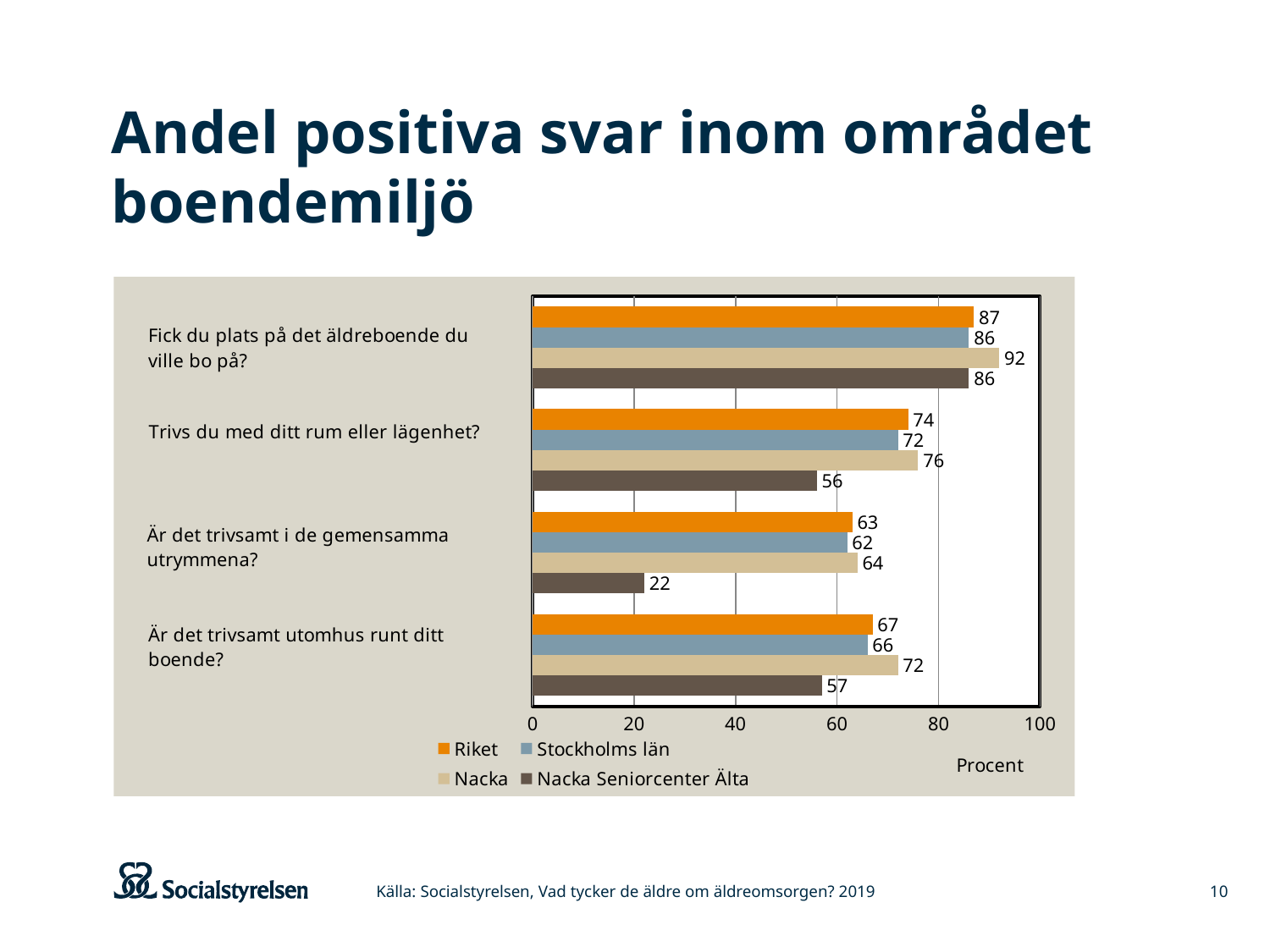
Is the value for Nacka Seniorcenter Älta on "Är det trivsamt i de gemensamma utrymmena?" greater or less than 40? less Which question has the lowest value for Nacka Seniorcenter Älta? Är det trivsamt i de gemensamma utrymmena? Which series has the highest value on "Fick du plats på det äldreboende du ville bo på?"? Nacka Which is larger on "Är det trivsamt utomhus runt ditt boende?": Nacka or Nacka Seniorcenter Älta? Nacka What is the value for Nacka Seniorcenter Älta on "Är det trivsamt i de gemensamma utrymmena?"? 22 What is the value for Nacka on "Fick du plats på det äldreboende du ville bo på?"? 92 What is the value for Stockholms län on "Är det trivsamt utomhus runt ditt boende?"? 66 How many series does the legend list? 4 What is the difference between Nacka and Nacka Seniorcenter Älta on "Trivs du med ditt rum eller lägenhet?"? 20 What is the value for Riket on "Trivs du med ditt rum eller lägenhet?"? 74 How many questions (categories) are shown on the chart? 4 What kind of chart is shown on the slide? Bar chart